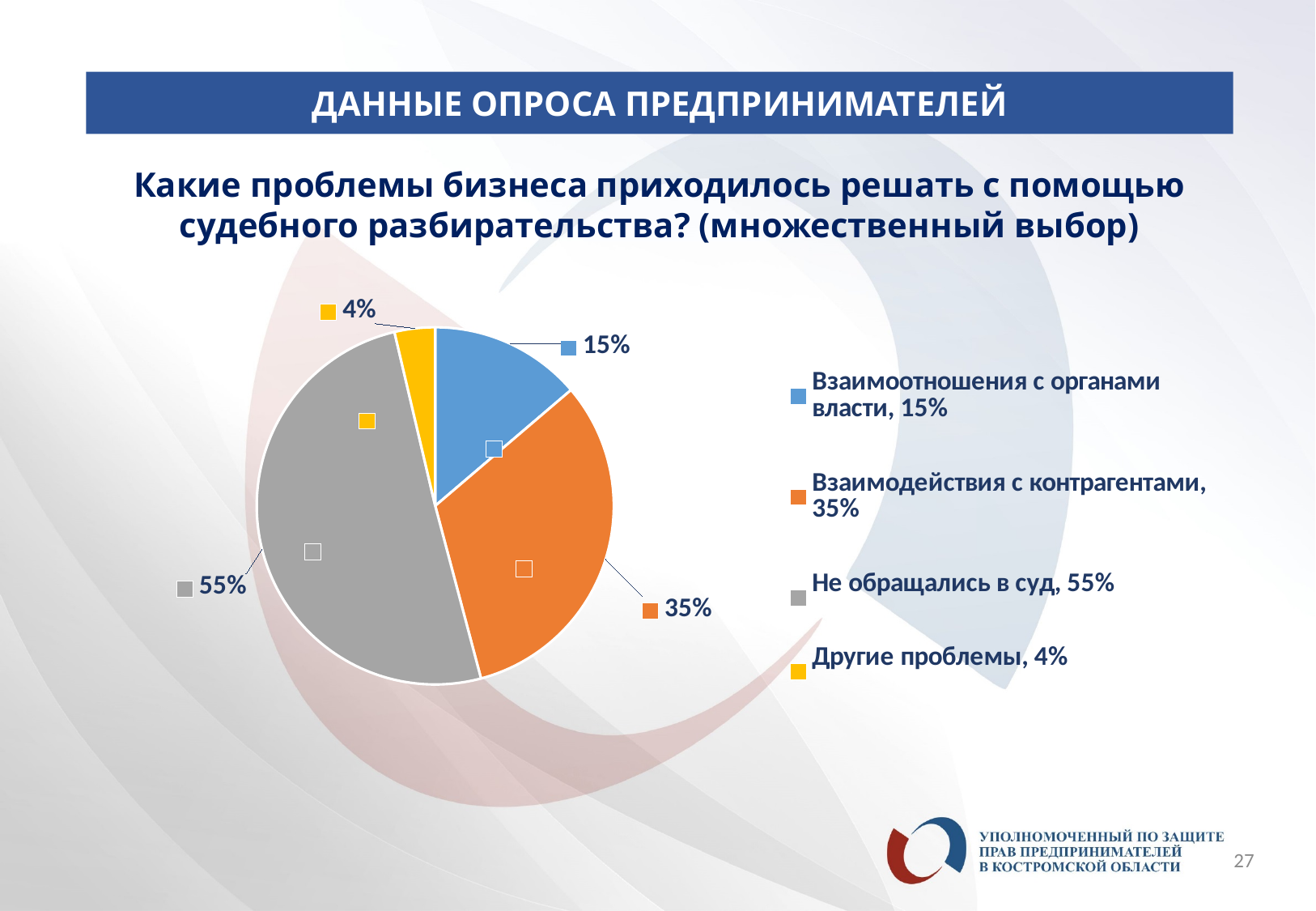
What share of the pie is labelled "Другие проблемы"? 4% Which category has the smallest slice of the pie? Другие проблемы Which is larger: the slice for "Взаимоотношения с органами власти" or the slice for "Взаимодействия с контрагентами"? Взаимодействия с контрагентами How many slices does the pie chart have? 4 What kind of chart is shown on the slide? Pie chart What is the difference in percentage points between "Не обращались в суд" and "Взаимодействия с контрагентами"? 20 What share of the pie is labelled "Взаимоотношения с органами власти"? 15% What colour is the slice for "Не обращались в суд"? Grey What share of the pie is labelled "Не обращались в суд"? 55% Which category has the largest slice of the pie? Не обращались в суд What share of the pie is labelled "Взаимодействия с контрагентами"? 35% How many entries does the legend list? 4